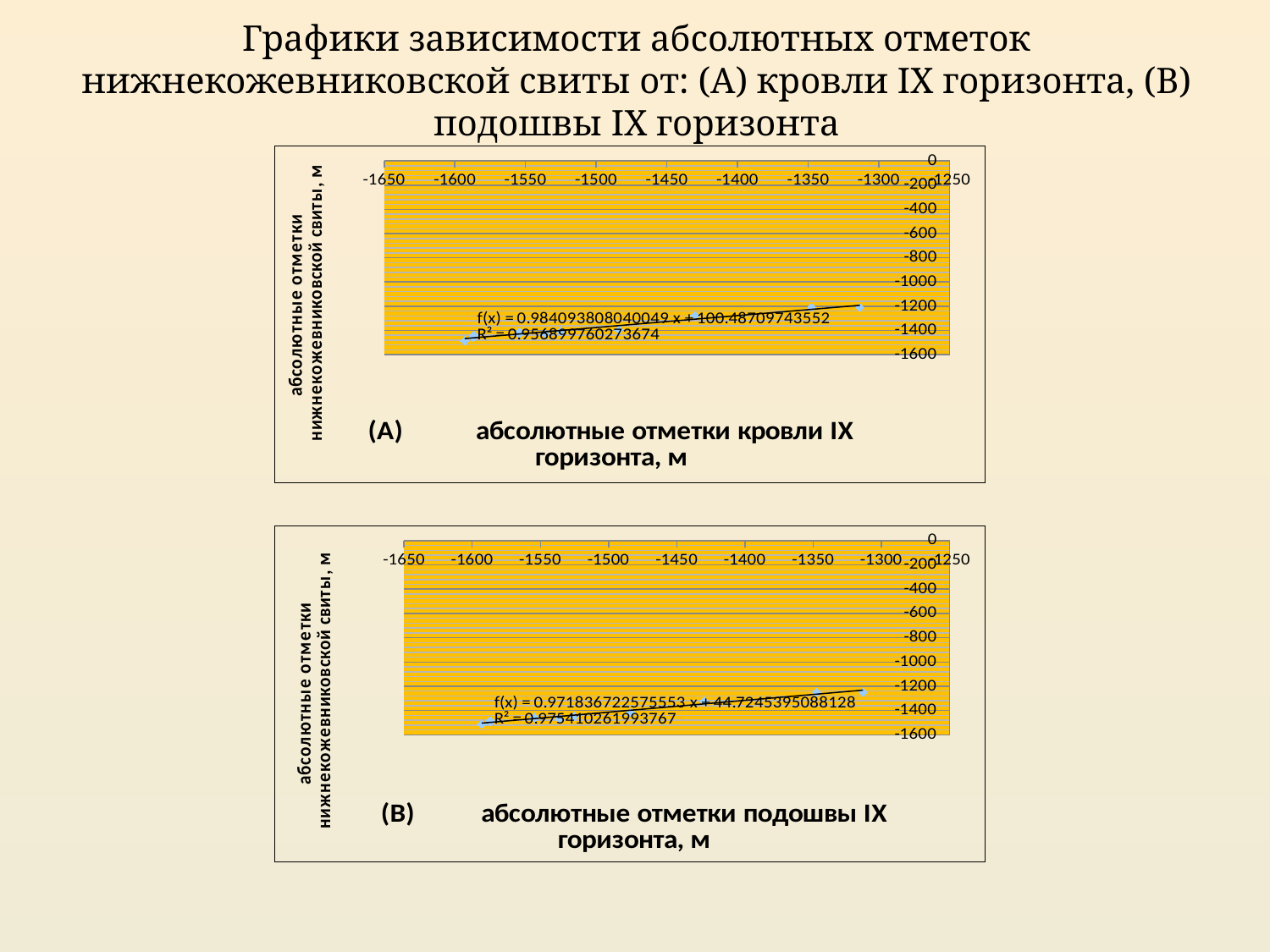
In chart (B), do the plotted values rise or fall as the x-axis values increase from -1650 to -1250? rise What is the x-axis title of chart (A), the upper chart? абсолютные отметки кровли IX горизонта, м What is the trendline equation printed on chart (B), the lower chart? f(x) = 0.971836722575553 x + 44.7245395088128 What is the trendline equation printed on chart (A), the upper chart? f(x) = 0.984093808040049 x + 100.48709743552 Which chart has the higher R² value, chart (A) or chart (B)? chart (B) How many charts are shown on the slide? 2 What is the R² value printed on chart (B), the lower chart? 0.975410261993767 What is the R² value printed on chart (A), the upper chart? 0.956899760273674 In chart (A), do the plotted values rise or fall as the x-axis values increase from -1650 to -1250? rise What is the x-axis title of chart (B), the lower chart? абсолютные отметки подошвы IX горизонта, м What kind of chart is chart (A), the upper chart on the slide? scatter chart with a trendline What kind of chart is chart (B), the lower chart on the slide? scatter chart with a trendline